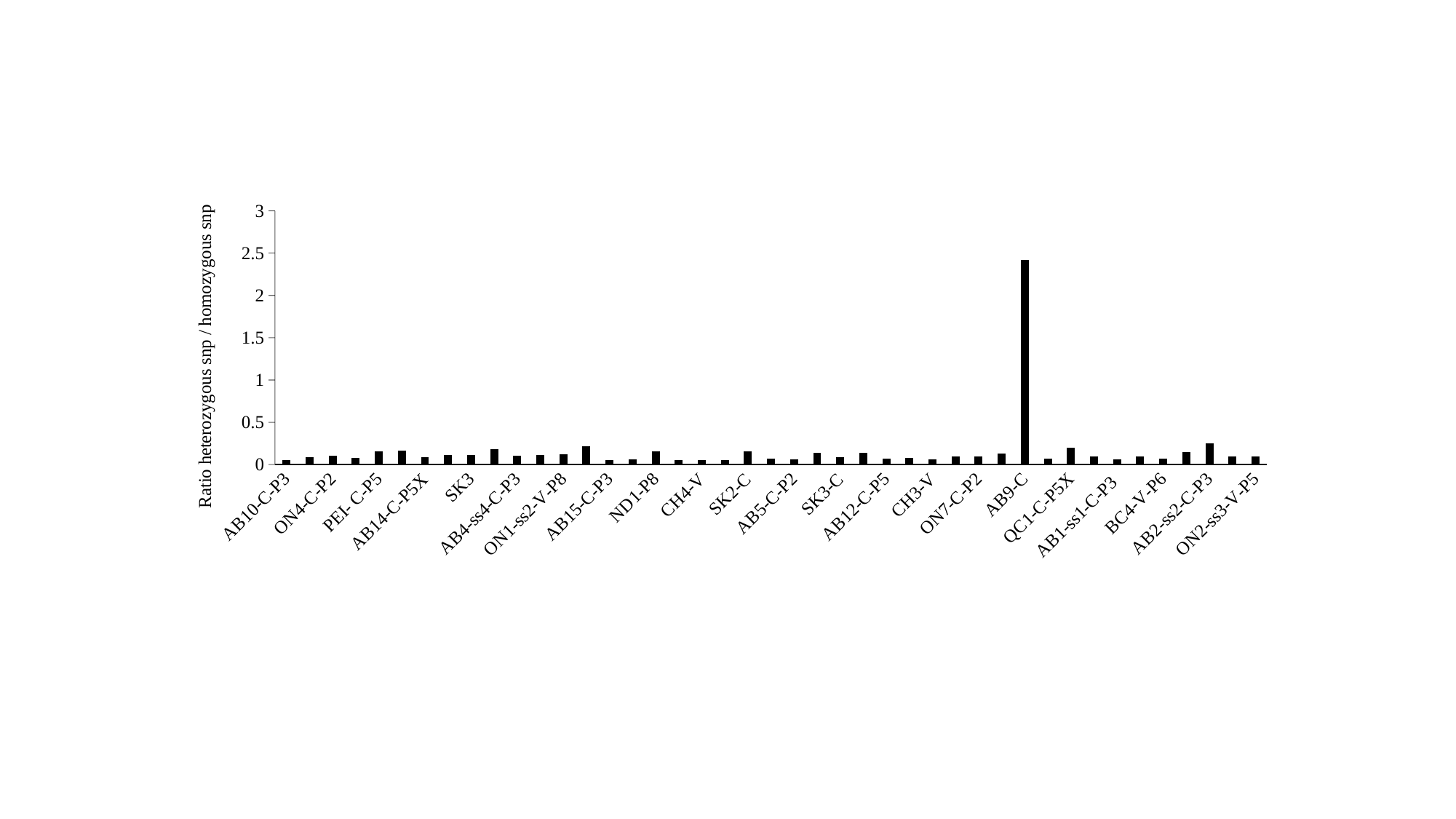
Is the value for AB10-C-P3 greater or less than 0.5? less How many category labels are printed along the x axis? 22 What is the label of the y axis? Ratio heterozygous snp / homozygous snp Is the value for AB9-C greater or less than 2? greater What kind of chart is shown on the slide? bar chart Is the value for QC1-C-P5X greater or less than 1? less What is the maximum value shown on the y axis? 3 Which has the larger value, AB9-C or ON2-ss3-V-P5? AB9-C Which has the larger value, AB9-C or QC1-C-P5X? AB9-C Which category has the highest ratio of heterozygous snp / homozygous snp? AB9-C